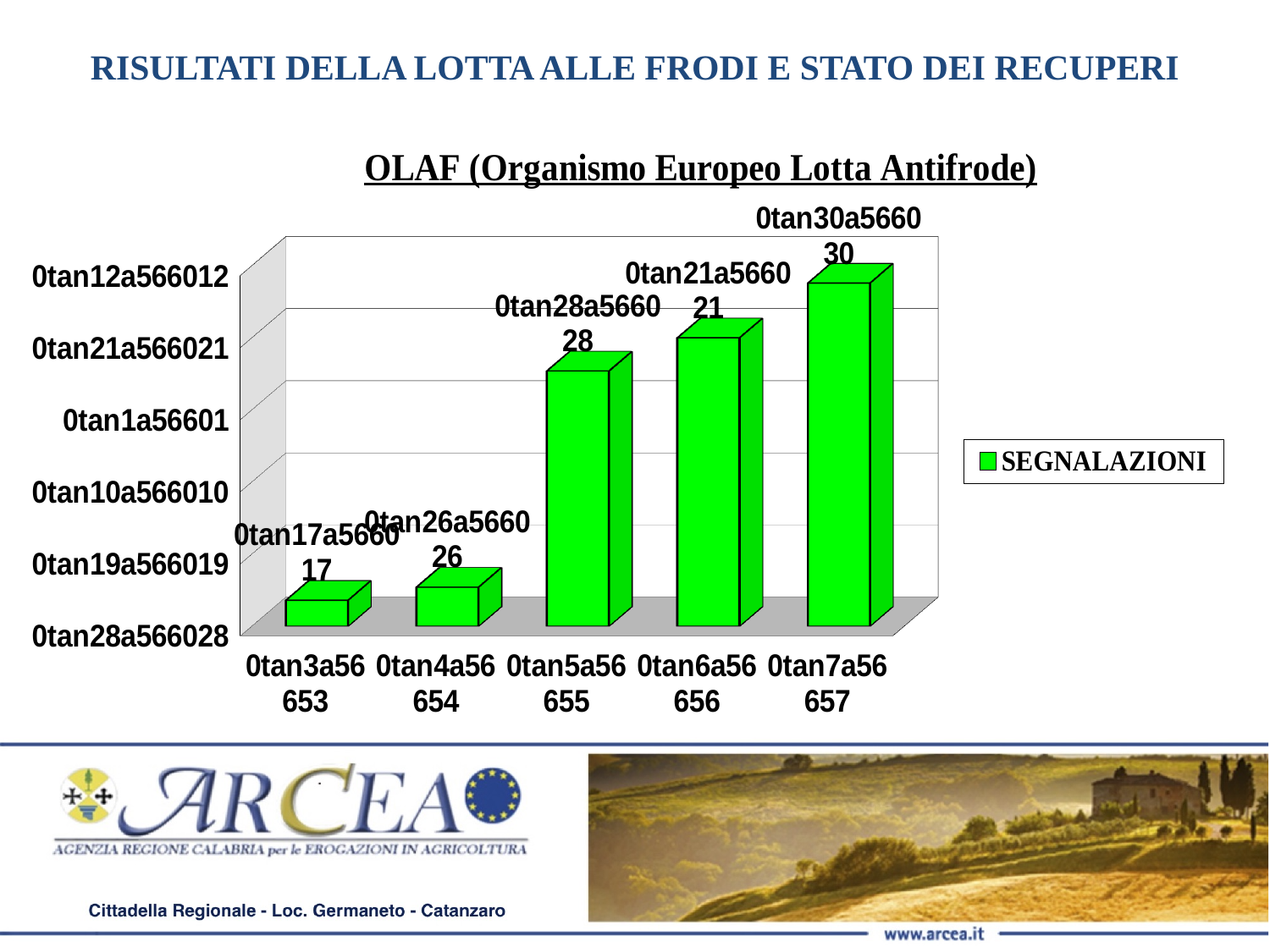
What kind of chart is shown on the slide? bar chart How many series does the chart legend list? 1 How many bars are plotted in the chart? 5 Which is taller, the fourth bar or the fifth bar from the left? the fifth bar Which is taller, the first bar or the second bar from the left? the second bar What is the title of the chart? OLAF (Organismo Europeo Lotta Antifrode) Do the bar values rise or fall from left to right along the x axis? rise What is the name of the series shown in the chart legend? SEGNALAZIONI Which bar is the tallest in the chart, by position from left to right? the fifth (rightmost) bar Which is taller, the second bar or the third bar from the left? the third bar Which bar is the shortest in the chart, by position from left to right? the first (leftmost) bar